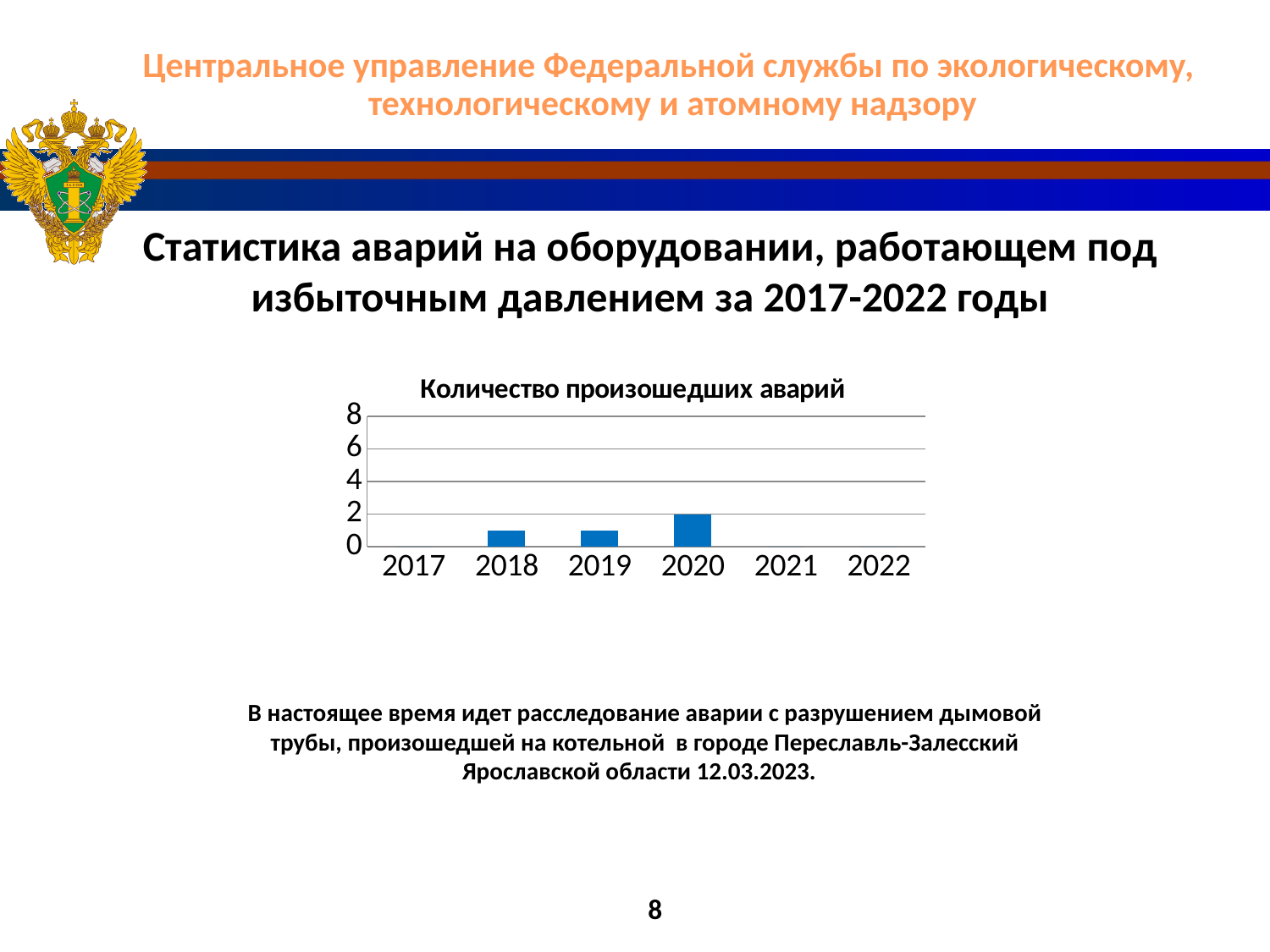
What is the title of the chart? Количество произошедших аварий Is the value for 2020 greater or less than 4? less Is the value for 2018 greater or less than 2? less How many years on the chart have no bar (zero accidents)? 3 What is the highest value shown on the vertical axis? 8 What is the number of accidents in 2021? 0 What kind of chart is shown on the slide? bar chart What is the difference between the values for 2020 and 2017? 2 What is the number of accidents in 2020? 2 Which year has more accidents, 2019 or 2020? 2020 How many years are shown on the x axis of the chart? 6 Which year has the highest number of accidents? 2020